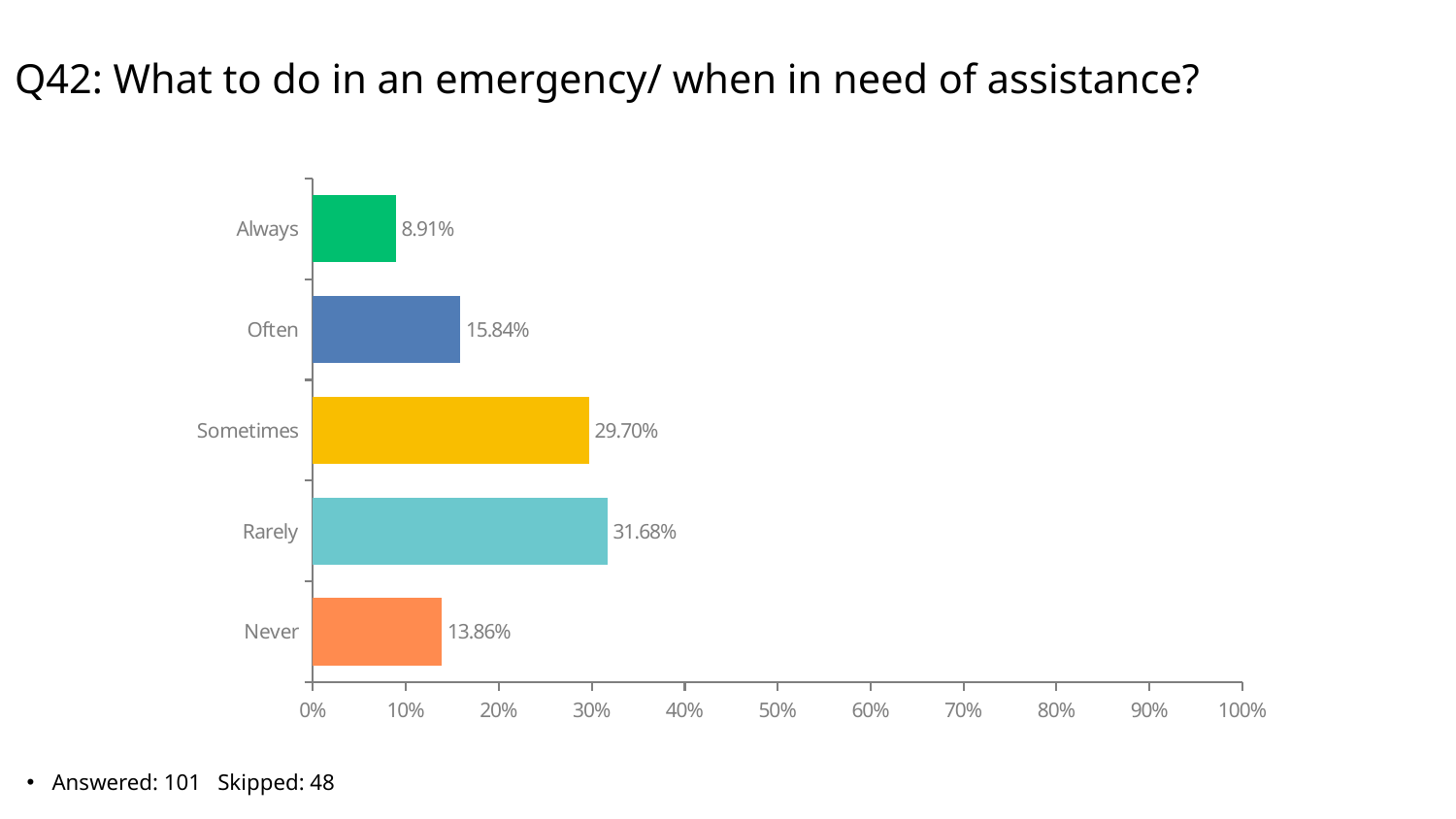
Is the value for Sometimes greater or less than 20%? greater Which category has the lowest value? Always How many categories are shown in the chart? 5 What is the difference between the values for Rarely and Sometimes? 1.98% Which category has the highest value? Rarely What is the value for Never? 13.86% What is the value for Always? 8.91% Which is larger, the value for Often or the value for Never? Often What is the value for Sometimes? 29.70% What kind of chart is shown on the slide? bar chart What is the title of the chart? Q42: What to do in an emergency/ when in need of assistance? What is the difference between the values for Often and Always? 6.93%